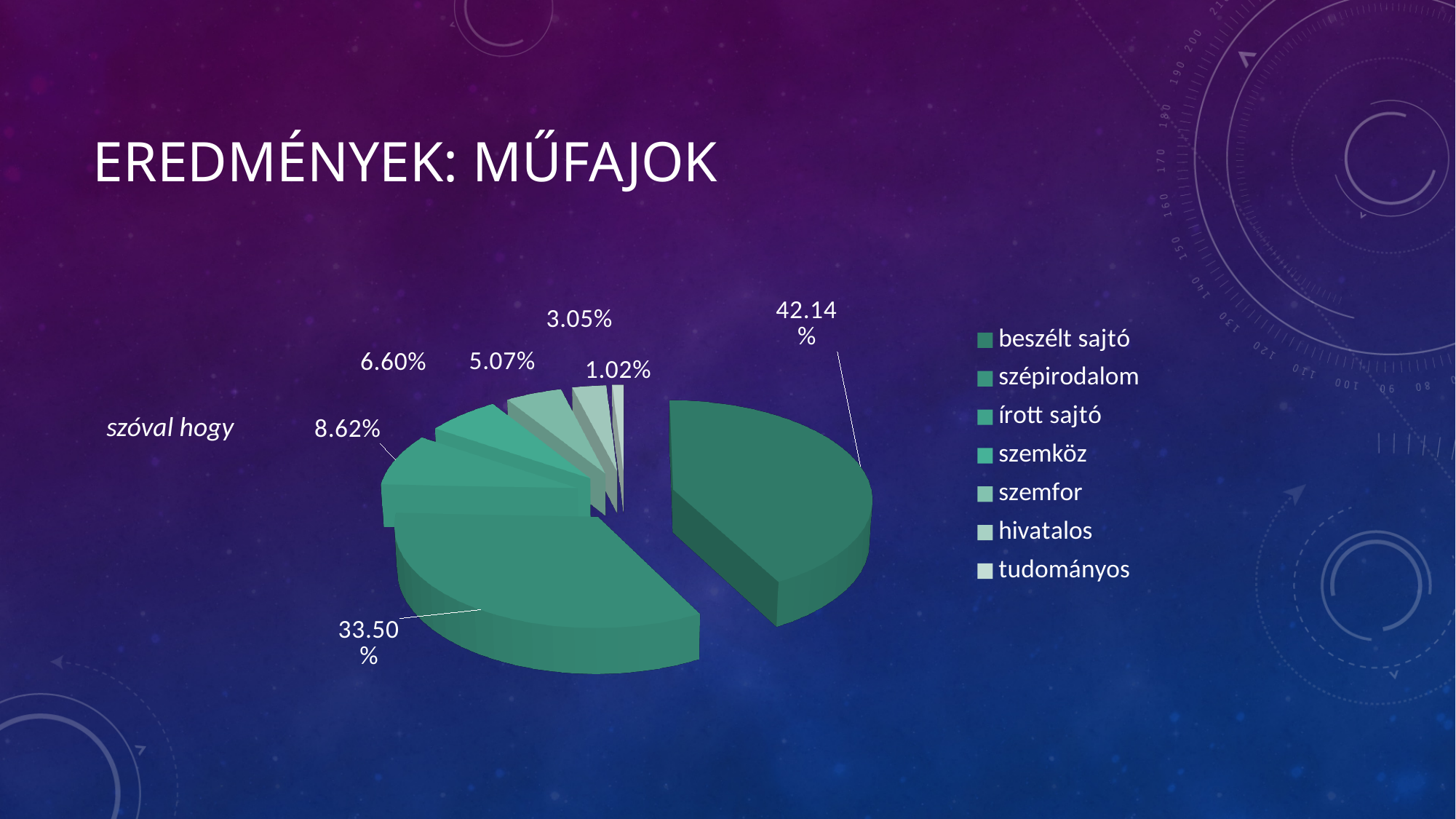
What is the difference in percentage points between beszélt sajtó and szépirodalom? 8.64 What share of the pie does tudományos have? 1.02% What share of the pie does szépirodalom have? 33.50% Which is larger, the share for szemköz or the share for szemfor? szemköz What is the combined share of hivatalos and tudományos? 4.07% What kind of chart is shown on the slide? pie chart Which category has the smallest slice of the pie? tudományos What share of the pie does beszélt sajtó have? 42.14% Which category has the largest slice of the pie? beszélt sajtó What is the title of the slide containing the pie chart? EREDMÉNYEK: MŰFAJOK How many categories does the legend of the pie chart list? 7 What share of the pie does írott sajtó have? 8.62%